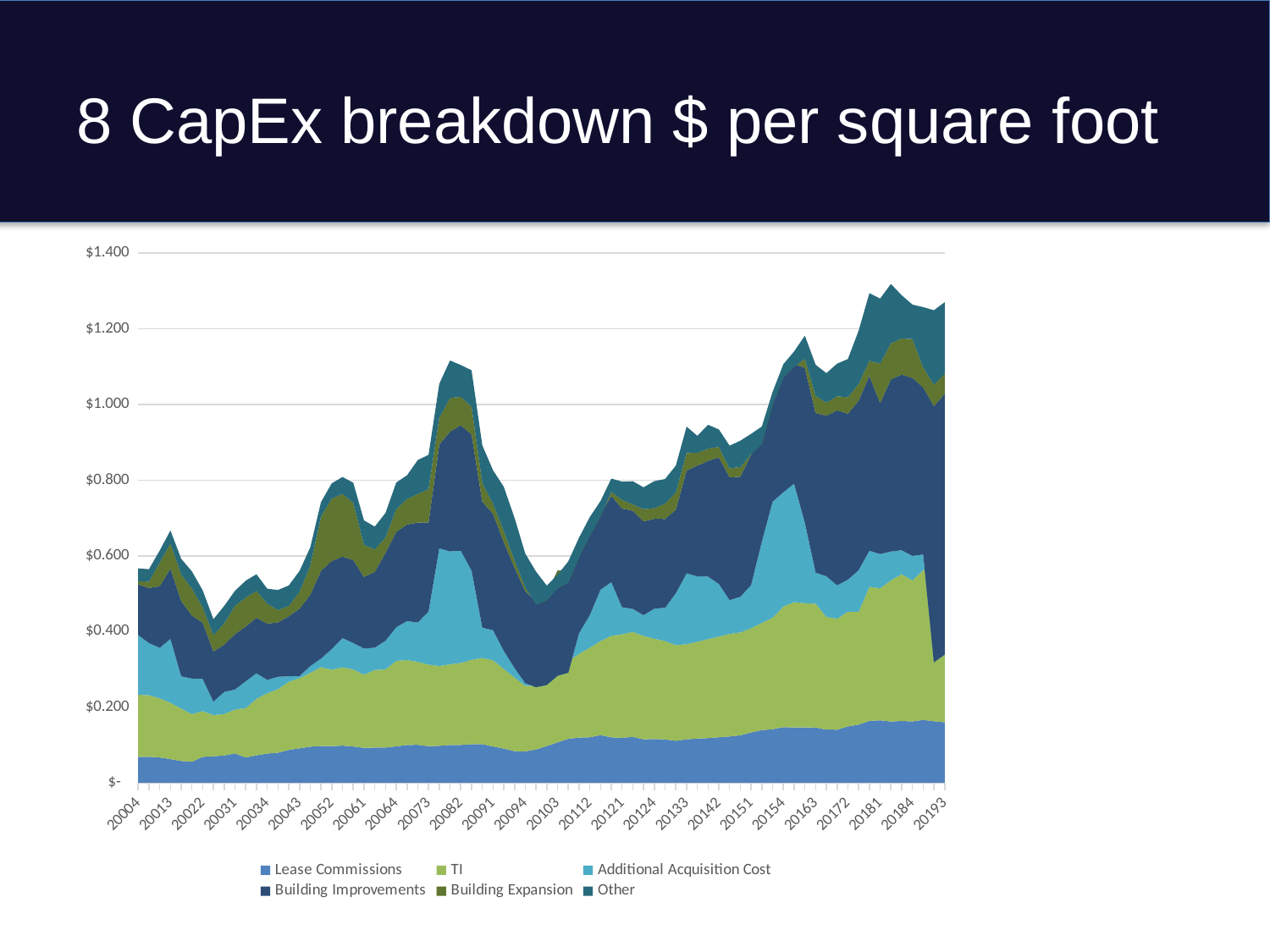
Is the stacked total at 20082 greater or less than $1.000? greater Which has the larger stacked total, 20082 or 20103? 20082 Does the stacked total generally rise or fall from 20004 to 20184? rise Which series is plotted at the bottom of the stack? Lease Commissions Which has the larger stacked total, 20004 or 20184? 20184 Is the stacked total at 20184 greater or less than $1.000? greater What kind of chart is shown on the slide? Stacked area chart Is the Lease Commissions value at 20004 greater or less than $0.200? less How many series does the legend list? 6 What is the title of the slide? 8 CapEx breakdown $ per square foot